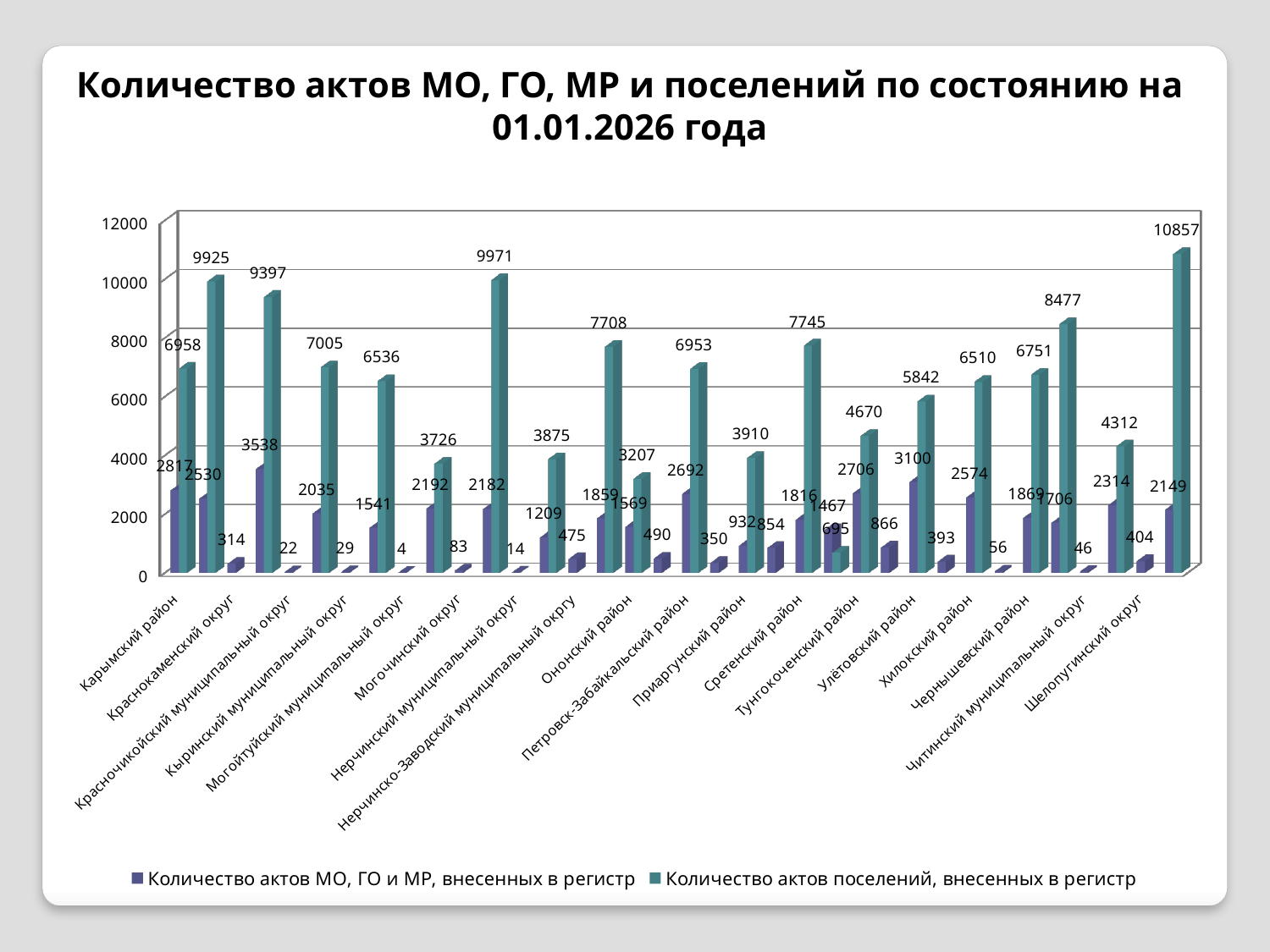
What is the highest value in the series 'Количество актов поселений, внесенных в регистр'? 10857 What kind of chart is shown on the slide? bar chart What is the lowest value in the series 'Количество актов МО, ГО и МР, внесенных в регистр'? 4 What is the highest value in the series 'Количество актов МО, ГО и МР, внесенных в регистр'? 3538 What is the value of 'Количество актов поселений, внесенных в регистр' for Карымский район? 6958 What is the value of 'Количество актов МО, ГО и МР, внесенных в регистр' for Карымский район? 2817 How many series does the legend list? 2 What is the title of the chart? Количество актов МО, ГО, МР и поселений по состоянию на 01.01.2026 года What is the difference between the highest and lowest values in the series 'Количество актов МО, ГО и МР, внесенных в регистр'? 3534